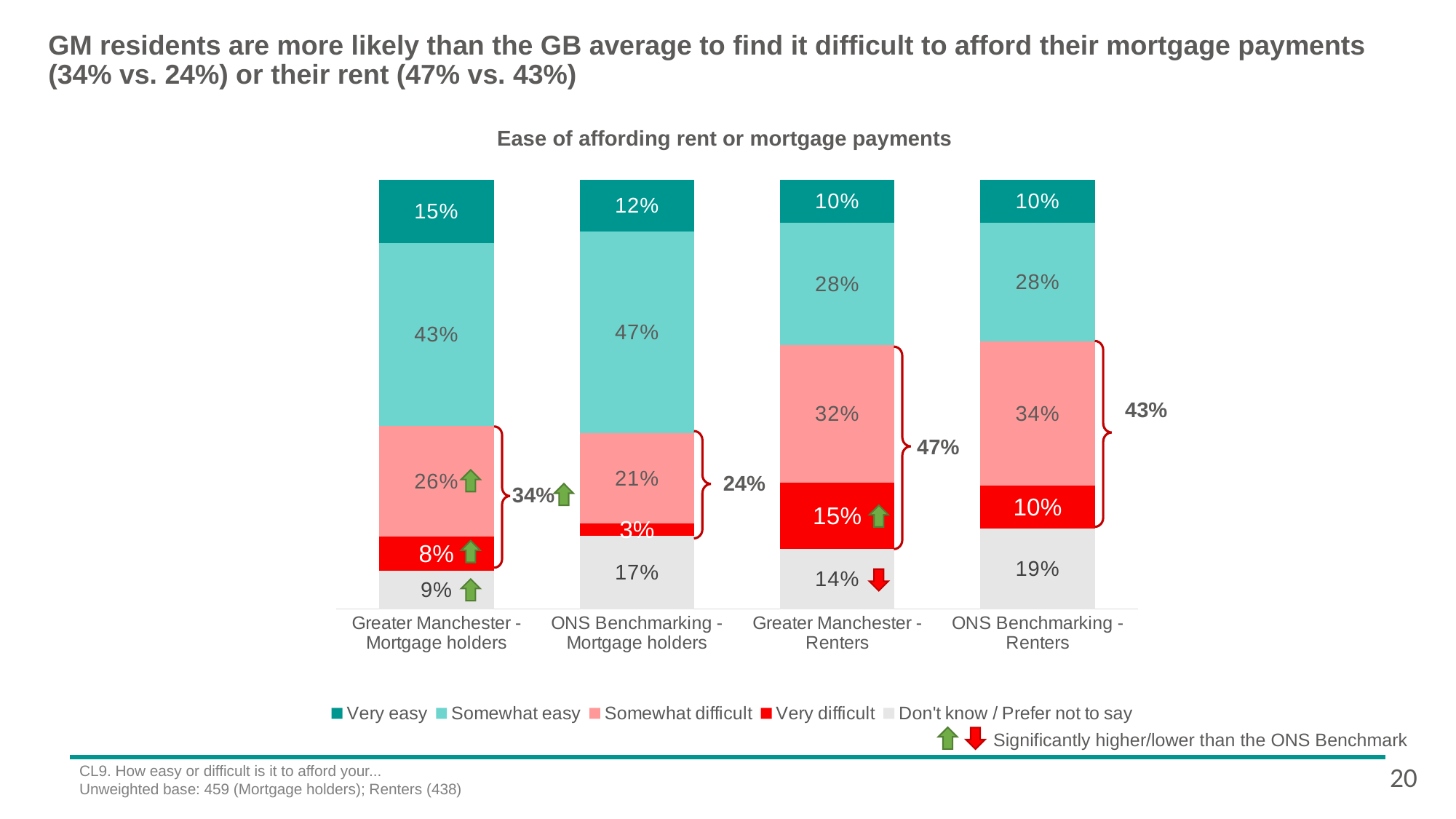
What is the difference between the 'Somewhat difficult' values for Greater Manchester - Mortgage holders and ONS Benchmarking - Mortgage holders? 5% What is the 'Very easy' value for Greater Manchester - Mortgage holders? 15% What is the 'Very difficult' value for Greater Manchester - Renters? 15% How many categories (bars) are shown on the x axis? 4 How many series does the legend list? 5 What is the chart's title? Ease of affording rent or mortgage payments Which is larger: the 'Somewhat easy' value for Greater Manchester - Mortgage holders or for Greater Manchester - Renters? Greater Manchester - Mortgage holders Which category has the highest 'Very difficult' value? Greater Manchester - Renters Which category has the lowest 'Very difficult' value? ONS Benchmarking - Mortgage holders What is the 'Don't know / Prefer not to say' value for ONS Benchmarking - Renters? 19% What type of chart is shown on the slide? Stacked bar chart What is the 'Somewhat easy' value for ONS Benchmarking - Mortgage holders? 47%